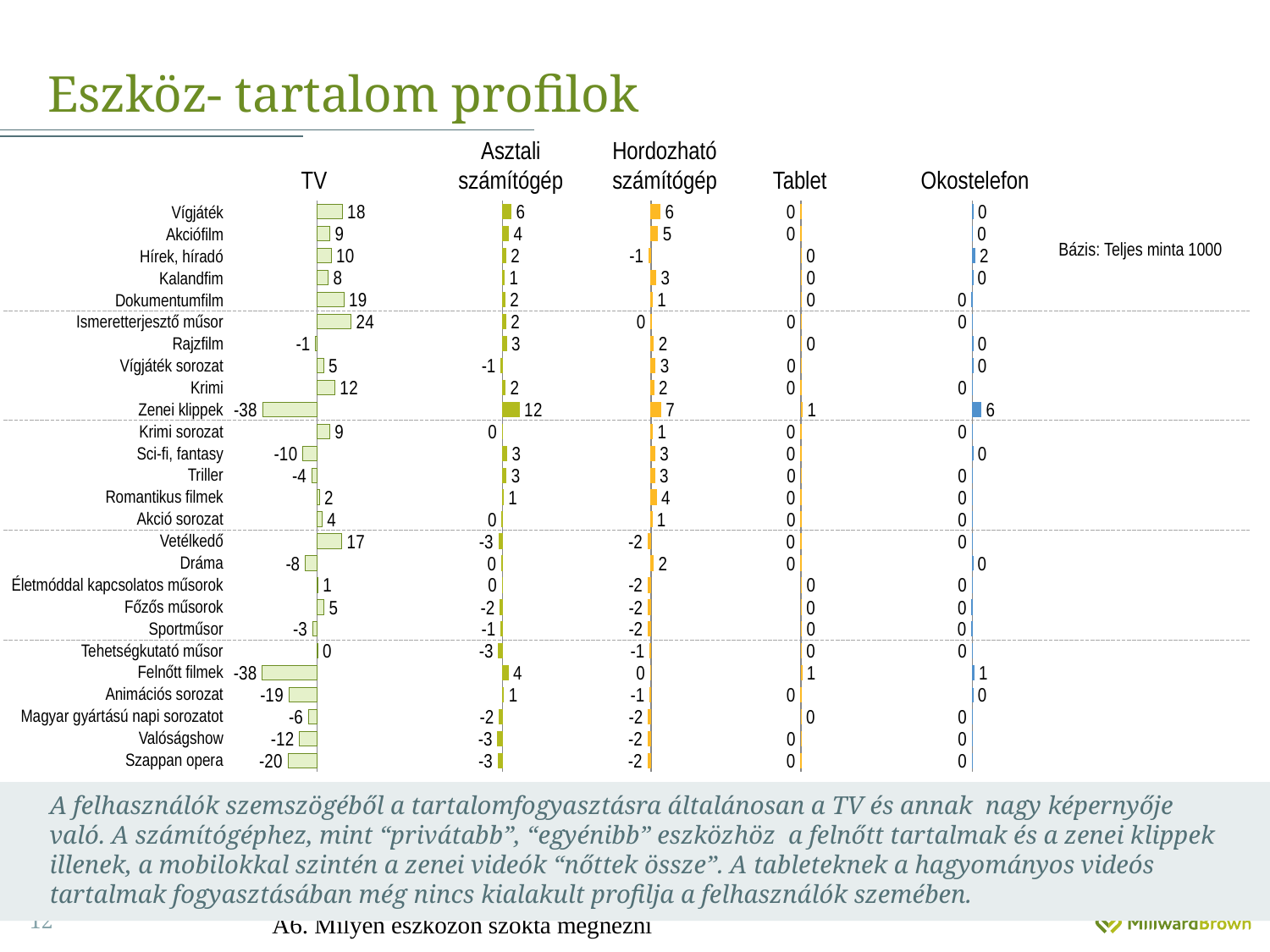
In the TV chart, which is larger, the value for Vetélkedő or the value for Krimi? Vetélkedő What type of chart is used for the TV data? Bar chart In the TV chart, what is the difference between the values for Vígjáték and Akciófilm? 9 In the TV chart, which category has the highest value? Ismeretterjesztő műsor In the Asztali számítógép chart, which category has the highest value? Zenei klippek In the Okostelefon chart, what is the value for Zenei klippek? 6 In the TV chart, what is the value for Zenei klippek? -38 In the Hordozható számítógép chart, which category has the highest value? Zenei klippek In the TV chart, what is the value for Ismeretterjesztő műsor? 24 In the Hordozható számítógép chart, what is the value for Romantikus filmek? 4 In the Asztali számítógép chart, what is the value for Zenei klippek? 12 How many content categories are listed in the charts? 26